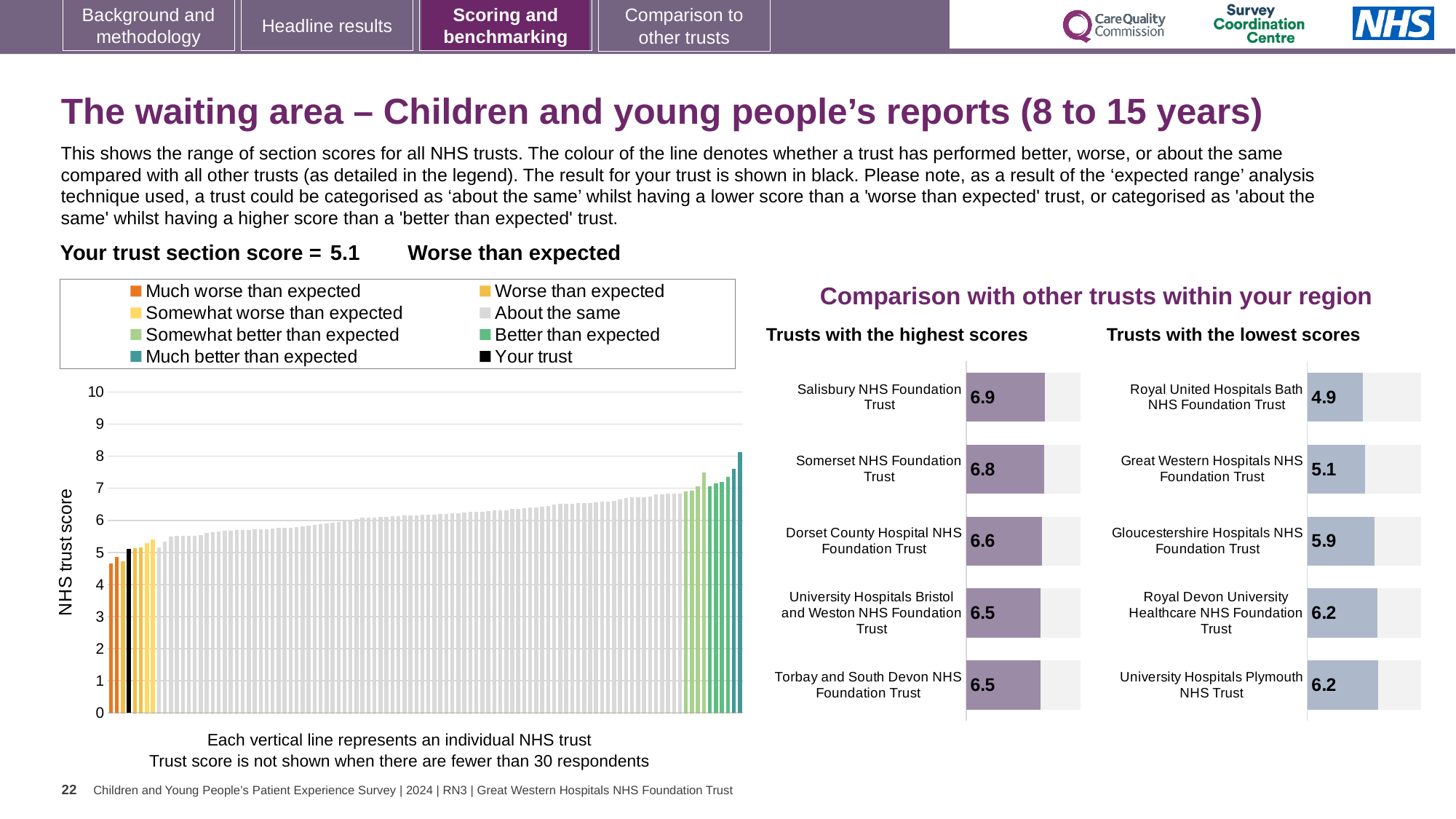
In the 'Trusts with the highest scores' chart, which trust has the highest score? Salisbury NHS Foundation Trust In the NHS trust score chart on the left, is the value of the leftmost (lowest) bar greater or less than 5? less In the 'Trusts with the lowest scores' chart, which trust has the lowest score? Royal United Hospitals Bath NHS Foundation Trust In the 'Trusts with the lowest scores' chart, what is the score for Royal United Hospitals Bath NHS Foundation Trust? 4.9 What kind of chart is the NHS trust score chart on the left of the slide? Bar chart How many trusts are shown in the 'Trusts with the highest scores' chart? 5 In the NHS trust score chart on the left, do the values rise or fall from left to right? Rise In the NHS trust score chart on the left, what colour is used for 'Your trust'? Black Which has the higher score: Dorset County Hospital NHS Foundation Trust in the highest scores chart or Gloucestershire Hospitals NHS Foundation Trust in the lowest scores chart? Dorset County Hospital NHS Foundation Trust In the 'Trusts with the highest scores' chart, what is the difference between the scores of Salisbury NHS Foundation Trust and Torbay and South Devon NHS Foundation Trust? 0.4 In the 'Trusts with the highest scores' chart, what is the score for Salisbury NHS Foundation Trust? 6.9 How many entries does the legend of the NHS trust score chart on the left list? 8